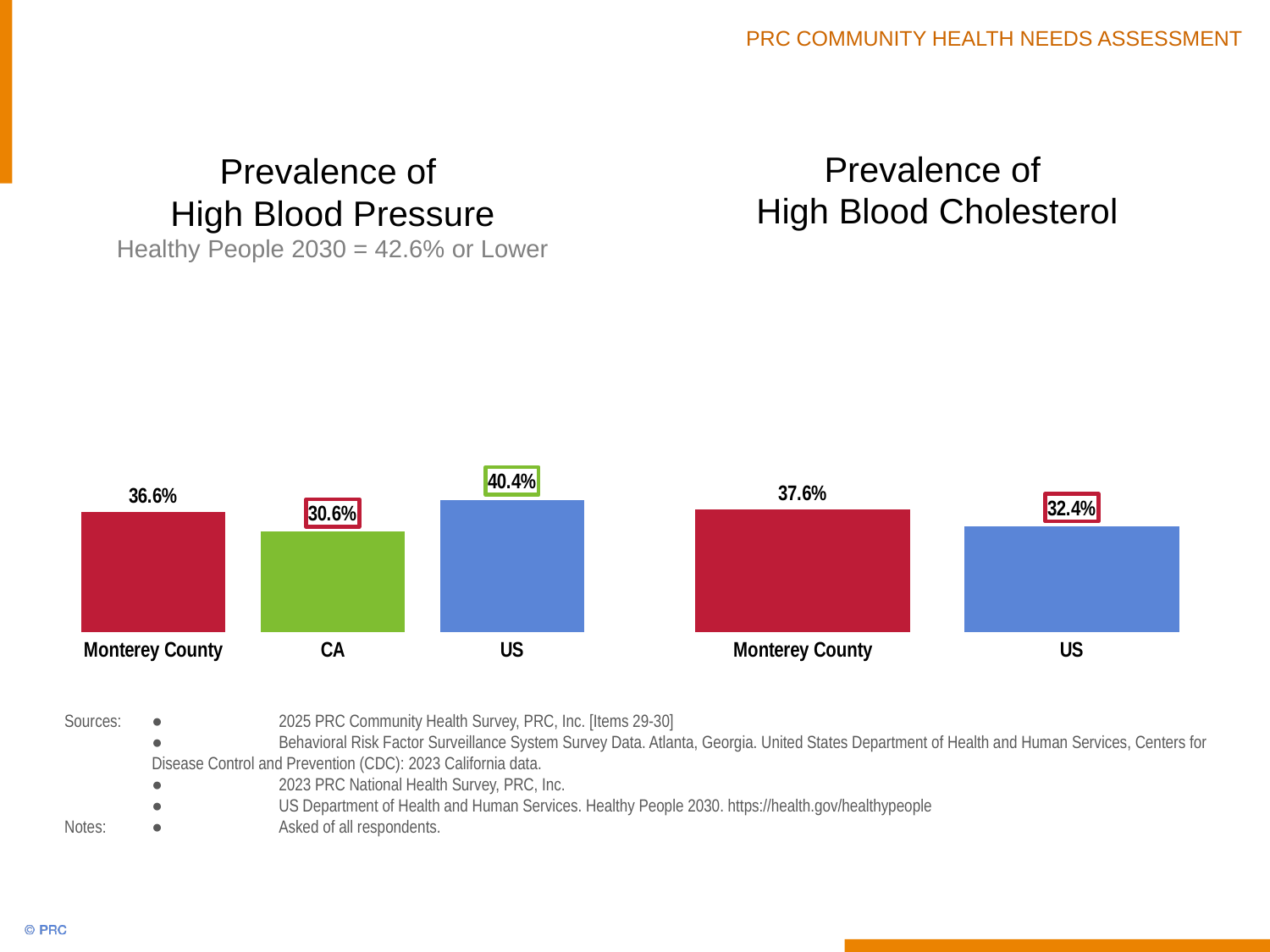
In the Prevalence of High Blood Cholesterol chart, what is the value for US? 32.4% In the Prevalence of High Blood Pressure chart, what is the value for Monterey County? 36.6% What Healthy People 2030 target is shown under the Prevalence of High Blood Pressure chart title? 42.6% or Lower In the Prevalence of High Blood Pressure chart, how many categories are shown? 3 In the Prevalence of High Blood Pressure chart, which category has the highest value? US In the Prevalence of High Blood Pressure chart, what is the difference between the US value and the CA value? 9.8% In the Prevalence of High Blood Cholesterol chart, which is larger, Monterey County or US? Monterey County In the Prevalence of High Blood Pressure chart, what is the value for CA? 30.6% In the Prevalence of High Blood Cholesterol chart, what is the value for Monterey County? 37.6% In the Prevalence of High Blood Cholesterol chart, what is the difference between Monterey County and US? 5.2% What kind of chart is the Prevalence of High Blood Cholesterol chart? Bar chart In the Prevalence of High Blood Pressure chart, which category has the lowest value? CA